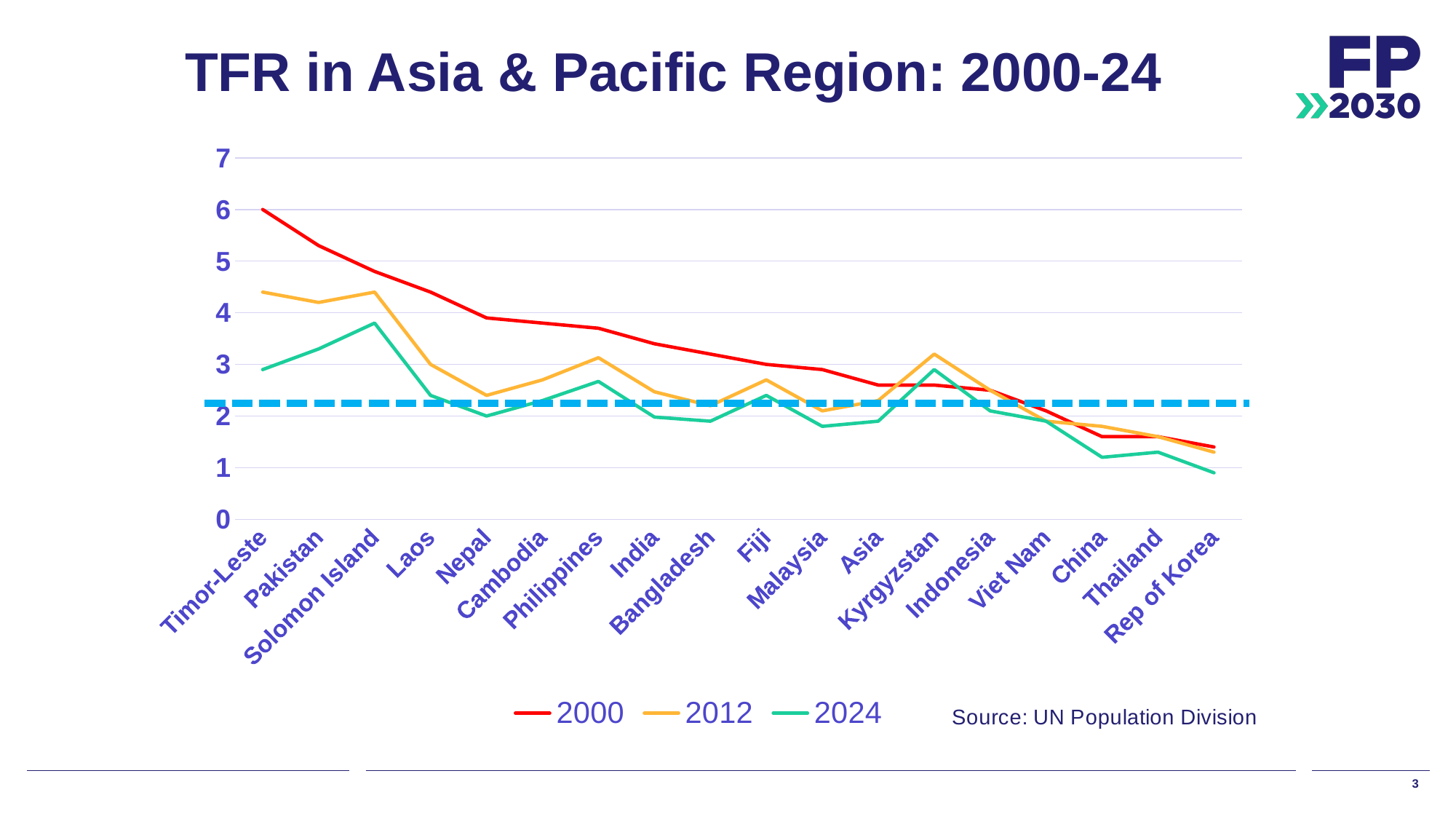
What kind of chart is shown on the slide? Line chart Which country has the highest TFR in the 2000 series? Timor-Leste How many series does the legend list? 3 Which country has the lowest TFR in the 2024 series? Rep of Korea Which country has the highest TFR in the 2024 series? Solomon Island How many countries or regions are plotted along the x axis? 18 What is the title of the chart? TFR in Asia & Pacific Region: 2000-24 Is the 2024 value for Solomon Island greater or less than 3? greater Which is larger for Kyrgyzstan: the 2012 value or the 2024 value? 2012 Is the 2000 value for Timor-Leste greater or less than 5? greater Is the 2024 value for China greater or less than 2? less Does the 2000 series generally rise or fall from left to right across the x axis? Fall